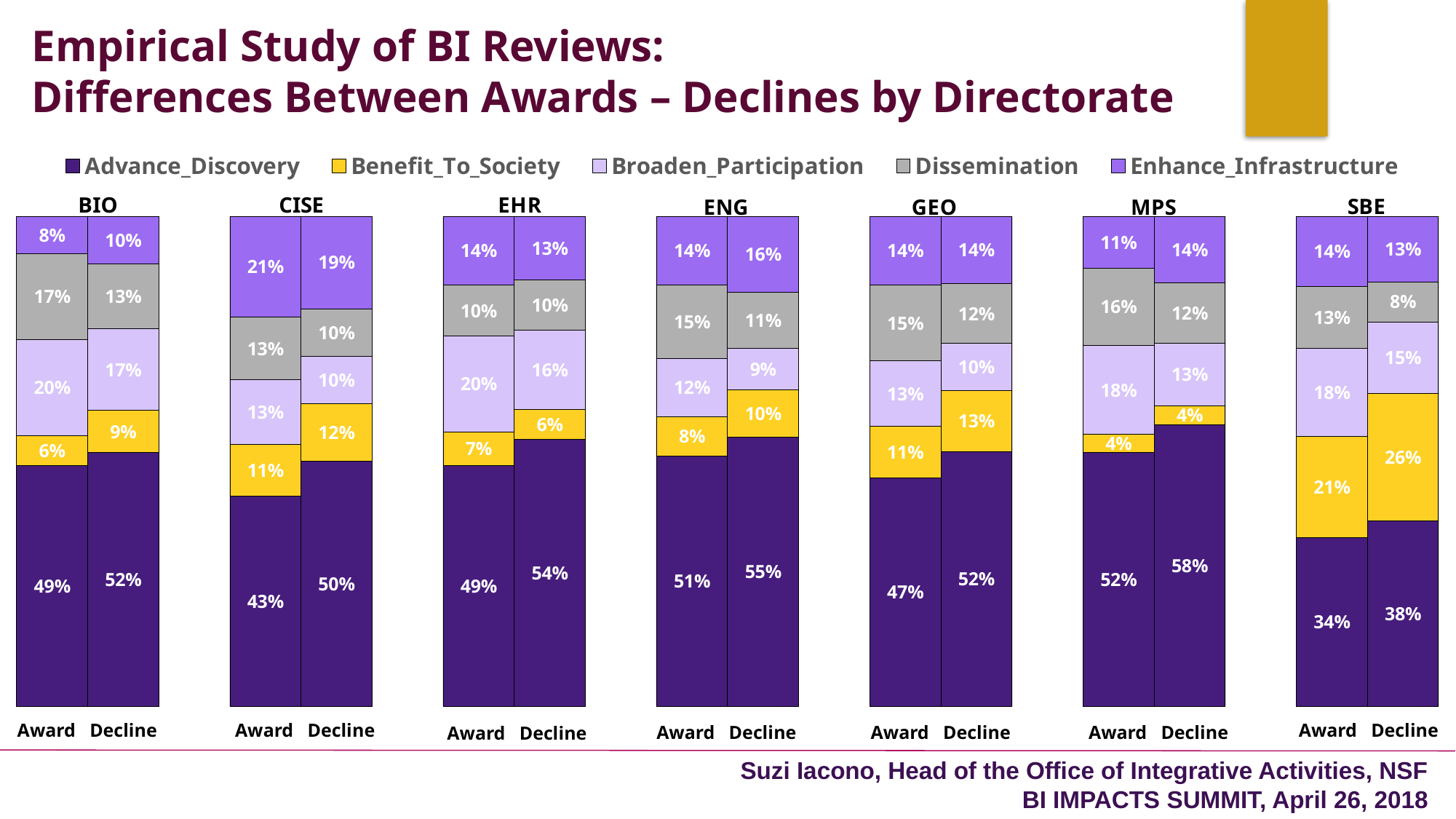
In the CISE chart, what is the Enhance_Infrastructure share for the Decline bar? 19% How many directorate charts are shown on the slide? 7 In the BIO chart, what is the total of the Award bar's segments? 100% In the BIO chart, what is the Advance_Discovery share for the Award bar? 49% In the MPS chart, which series has the smallest share in the Decline bar? Benefit_To_Society In the MPS chart, what is the Broaden_Participation share for the Award bar? 18% In the GEO chart, which bar has the larger Dissemination share, Award or Decline? Award How many series does the legend list? 5 In the SBE chart, what is the Benefit_To_Society share for the Decline bar? 26% In the EHR chart, which series has the largest share in the Award bar? Advance_Discovery What kind of chart is used for each directorate? Stacked bar chart In the ENG chart, what is the difference between the Advance_Discovery shares of the Decline and Award bars? 4%